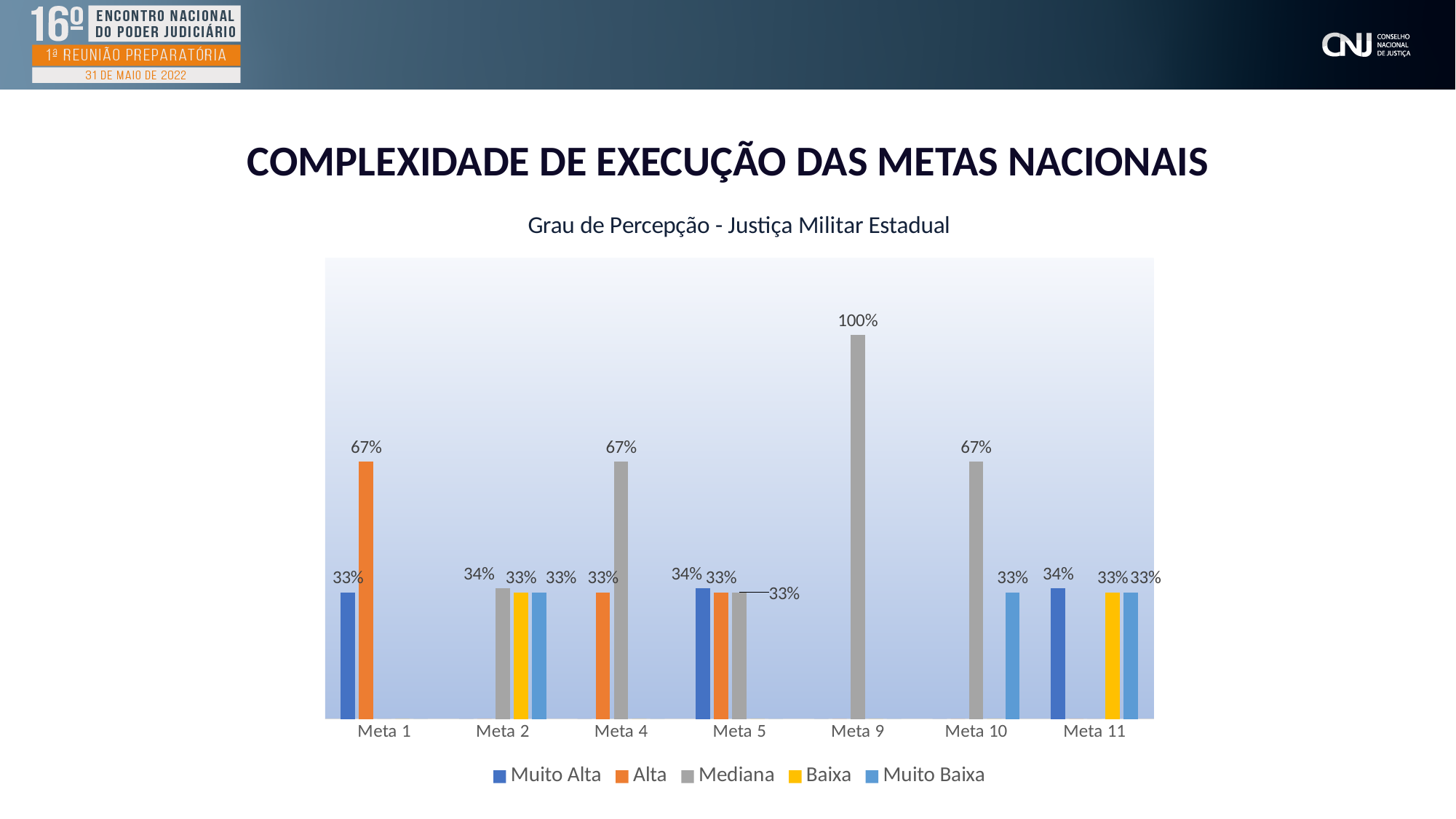
What is the title of the chart? Grau de Percepção - Justiça Militar Estadual What is the value of Mediana for Meta 9? 100% How many categories (Metas) are shown on the x axis? 7 What is the value of Muito Baixa for Meta 10? 33% What is the value of Mediana for Meta 4? 67% What is the difference between the Alta value and the Muito Alta value for Meta 1? 34% What is the value of Muito Alta for Meta 11? 34% What kind of chart is shown on the slide? Bar chart How many series does the legend list? 5 Which category has the highest Mediana value? Meta 9 What is the value of Alta for Meta 1? 67% Which is larger for Meta 4: the Alta value or the Mediana value? Mediana